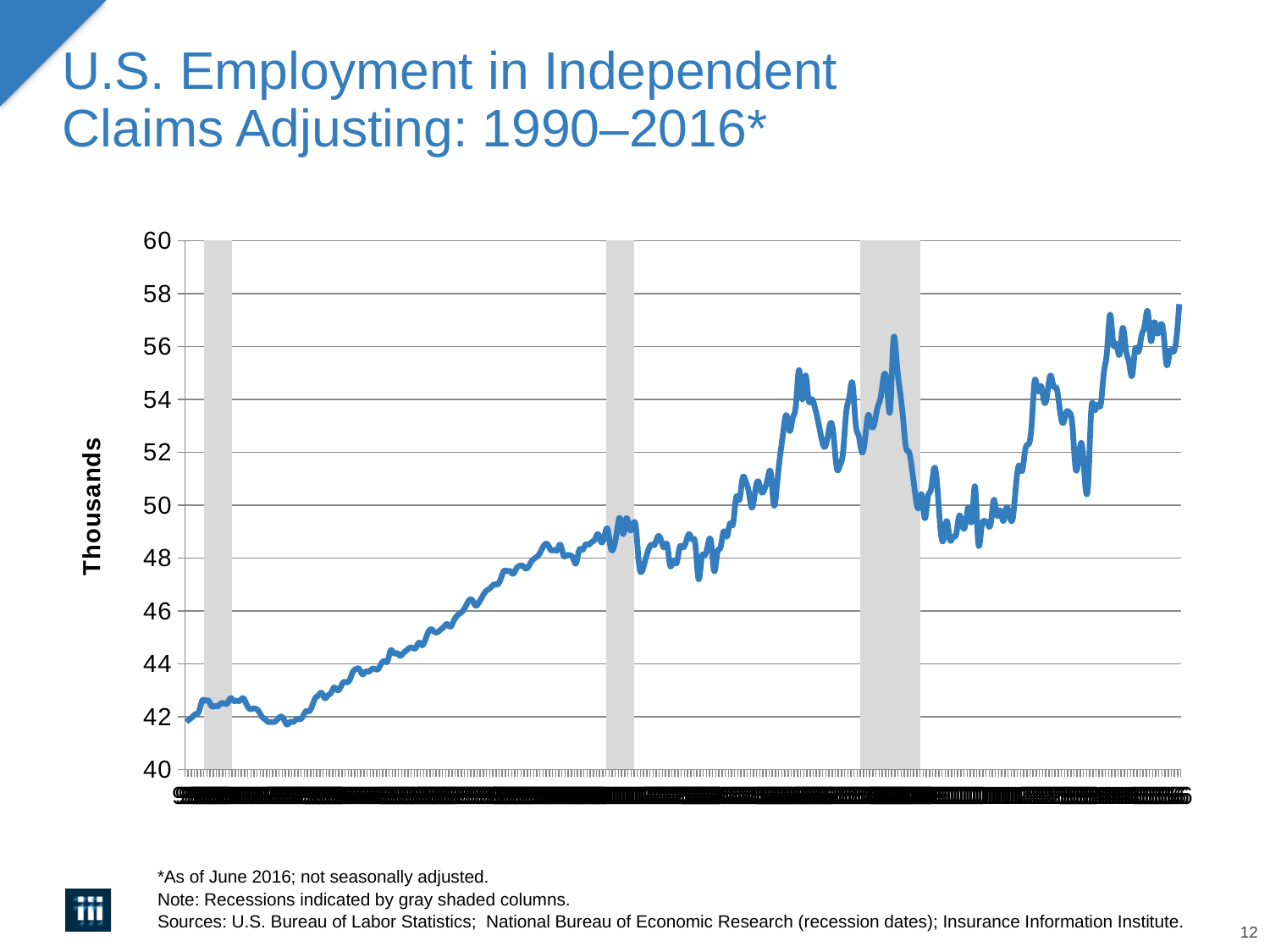
What is the label on the vertical axis of the chart? Thousands Is the lowest point on the line greater or less than 44? less Is the value at the end of the series (2016) higher or lower than the value at the start (1990)? higher Overall, do the values rise or fall from 1990 to 2016 along the x axis? rise Is the value at the end of the series (June 2016) greater or less than 56? greater Is the value at the start of the series (1990) greater or less than 40? greater What kind of chart is shown on the slide? line chart How many gray shaded recession columns are shown on the chart? 3